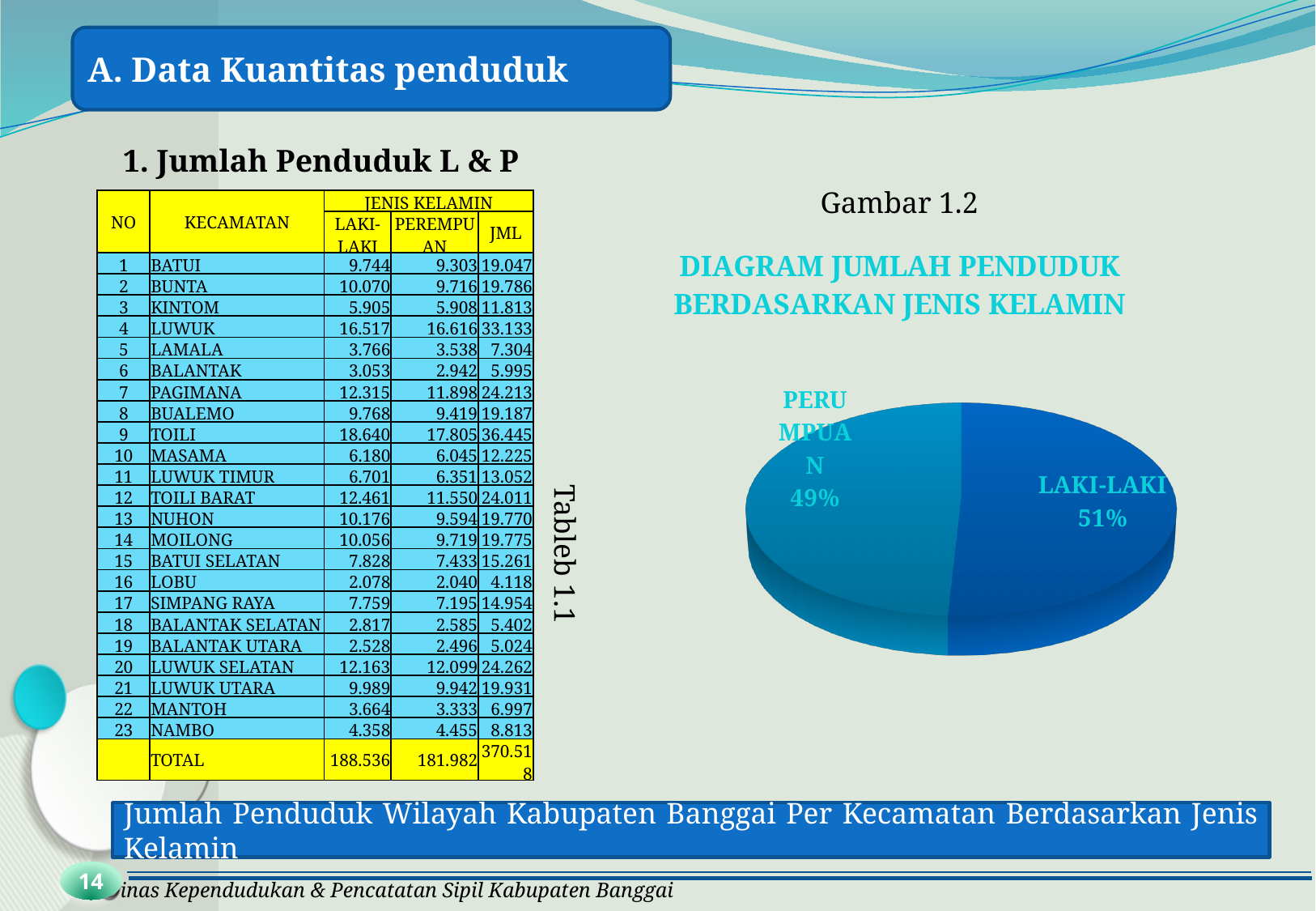
What kind of chart is shown on the slide? pie chart Which slice of the pie chart is the smallest? PEREMPUAN Is the share for LAKI-LAKI greater or less than 50%? greater How many slices does the pie chart have? 2 Which is larger in the pie chart, LAKI-LAKI or PEREMPUAN? LAKI-LAKI What figure number is given to the pie chart? Gambar 1.2 What is the difference in percentage points between the LAKI-LAKI and PEREMPUAN slices? 2 percentage points Which slice of the pie chart is the largest? LAKI-LAKI What is the title of the pie chart? DIAGRAM JUMLAH PENDUDUK BERDASARKAN JENIS KELAMIN What share of the pie chart does PEREMPUAN represent? 49% What share of the pie chart does LAKI-LAKI represent? 51%